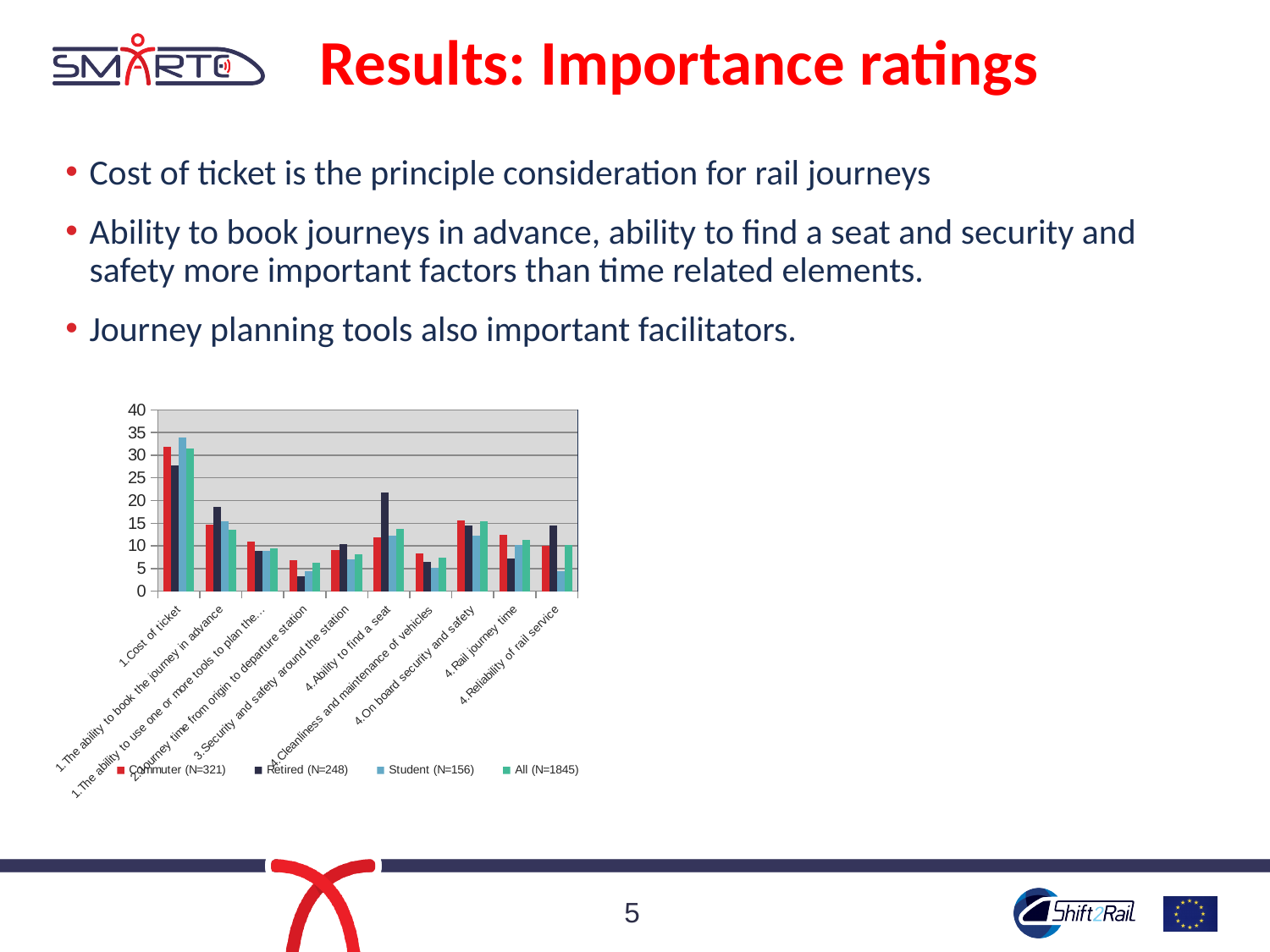
Which category has the highest value for the Student (N=156) series? 1.Cost of ticket Which category has the lowest value for the Retired (N=248) series? 2.Journey time from origin to departure station How many categories are shown along the x axis of the chart? 10 Is the value for Retired (N=248) in the category 2.Journey time from origin to departure station greater or less than 5? less Is the value for Student (N=156) in the category 1.Cost of ticket greater or less than 30? greater In the category 4.Ability to find a seat, which series has the larger value: Retired (N=248) or Commuter (N=321)? Retired (N=248) Is the value for Retired (N=248) in the category 4.Ability to find a seat greater or less than 20? greater What is the sample size shown in the legend for the All series? N=1845 What kind of chart is shown on the slide? bar chart In the category 1.Cost of ticket, which series has the larger value: Student (N=156) or Retired (N=248)? Student (N=156) How many series does the chart's legend list? 4